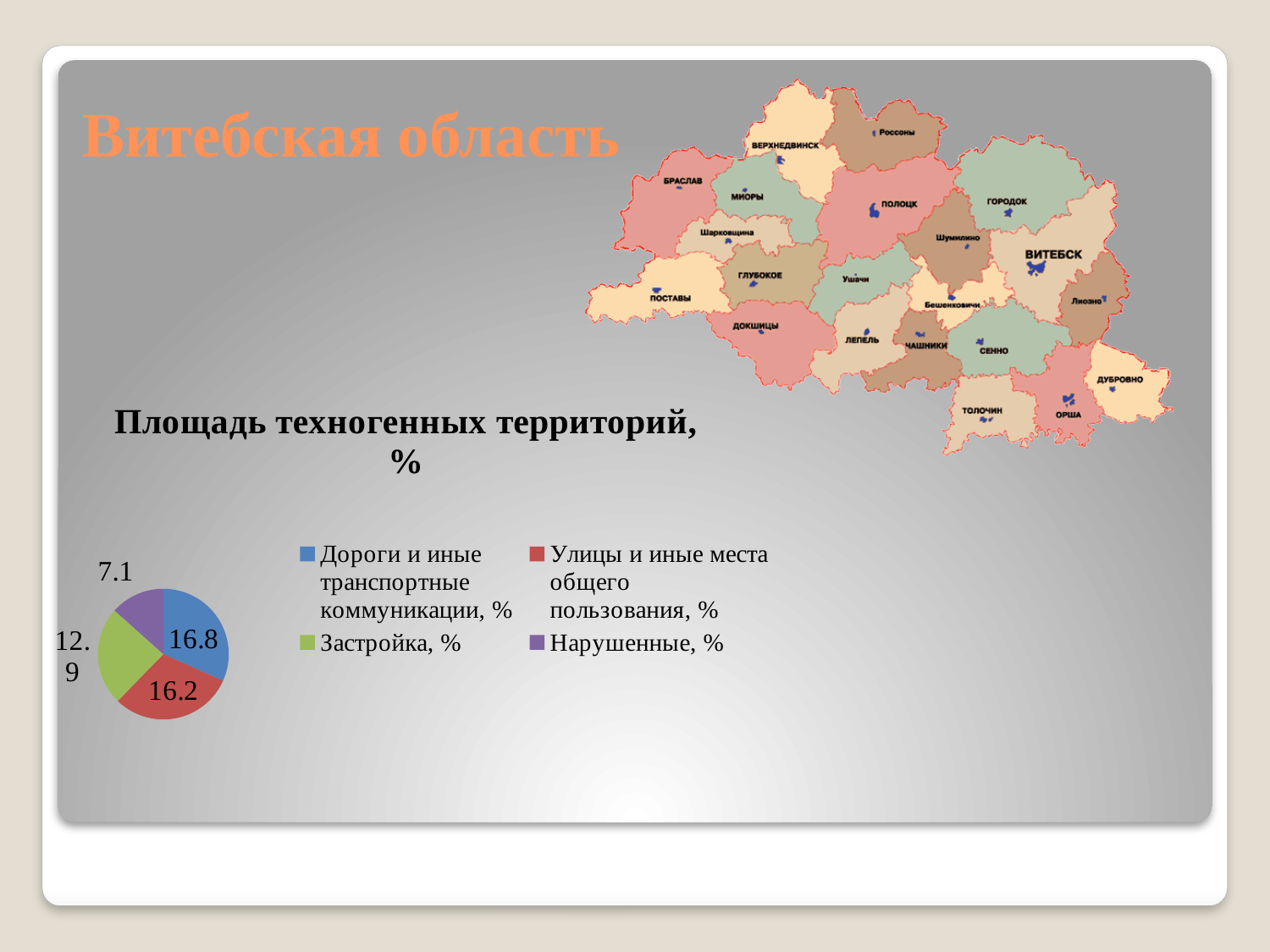
Which category has the smallest slice of the pie? Нарушенные, % What type of chart is shown on the slide? pie chart What is the difference between the values for "Застройка, %" and "Нарушенные, %"? 5.8 How many slices does the pie chart have? 4 What value is shown for "Нарушенные, %"? 7.1 What value is shown for "Улицы и иные места общего пользования, %"? 16.2 What value is shown for "Дороги и иные транспортные коммуникации, %"? 16.8 Which category has the largest slice of the pie? Дороги и иные транспортные коммуникации, % What is the title of the chart? Площадь техногенных территорий, % Which colour represents "Застройка, %" in the pie chart? green What value is shown for "Застройка, %"? 12.9 How many entries does the legend list? 4